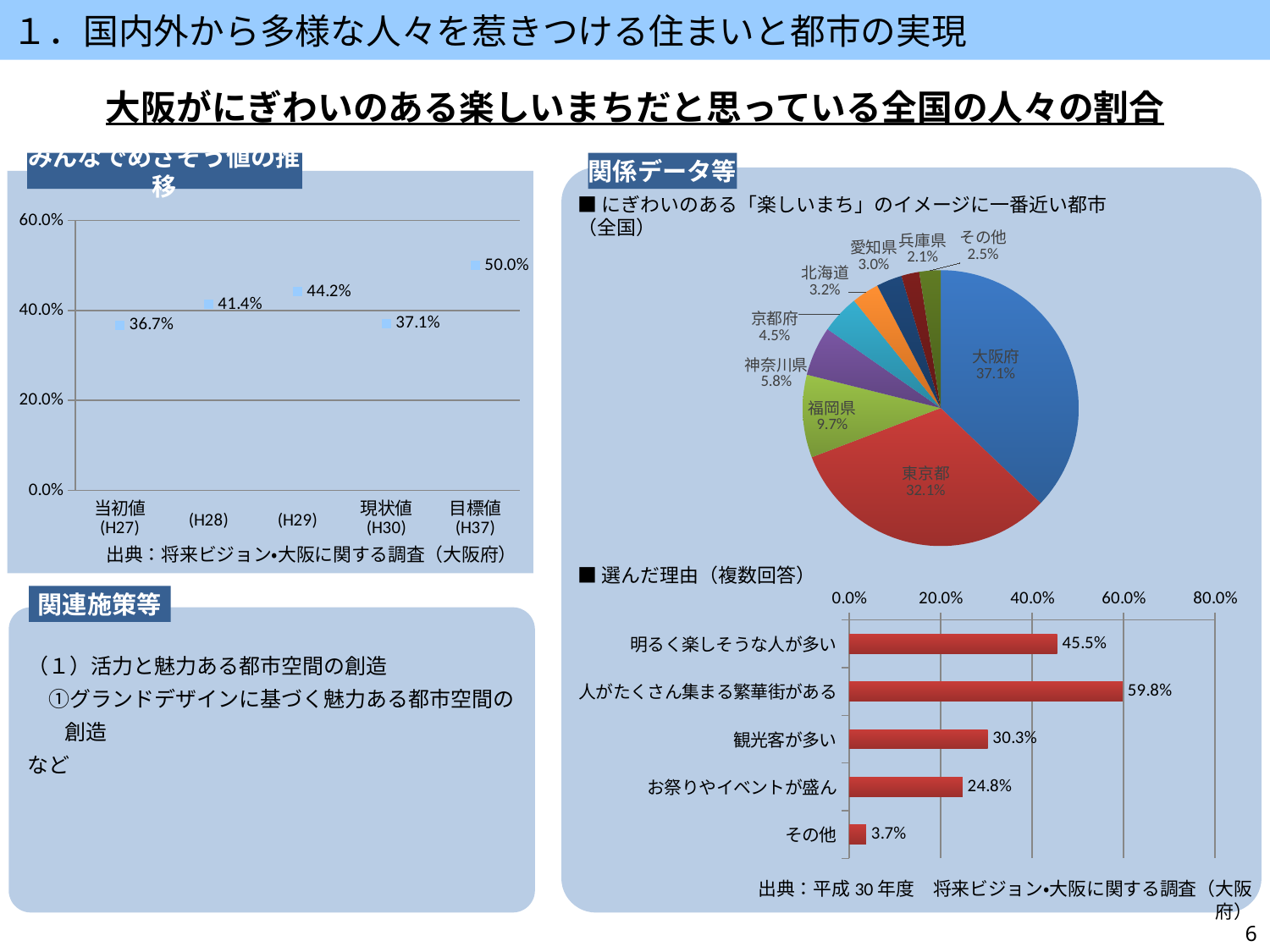
What kind of chart is the chart titled 選んだ理由 at the bottom right? bar chart In the left chart (みんなでめざそう値の推移), what is the value for 当初値 (H27)? 36.7% In the bar chart (選んだ理由), what is the value for 人がたくさん集まる繁華街がある? 59.8% In the left chart (みんなでめざそう値の推移), which point has the highest value? 目標値 (H37) In the bar chart (選んだ理由), which reason has the lowest value? その他 In the left chart (みんなでめざそう値の推移), what is the difference between the (H29) value and the 現状値 (H30) value? 7.1% In the pie chart (にぎわいのある「楽しいまち」のイメージに一番近い都市), what share does 東京都 have? 32.1% In the left chart (みんなでめざそう値の推移), how many data points are plotted? 5 In the pie chart (にぎわいのある「楽しいまち」のイメージに一番近い都市), how many slices are there? 9 In the pie chart (にぎわいのある「楽しいまち」のイメージに一番近い都市), which prefecture has the largest slice? 大阪府 In the pie chart (にぎわいのある「楽しいまち」のイメージに一番近い都市), which is larger, 福岡県 or 神奈川県? 福岡県 In the left chart (みんなでめざそう値の推移), what is the value for 目標値 (H37)? 50.0%